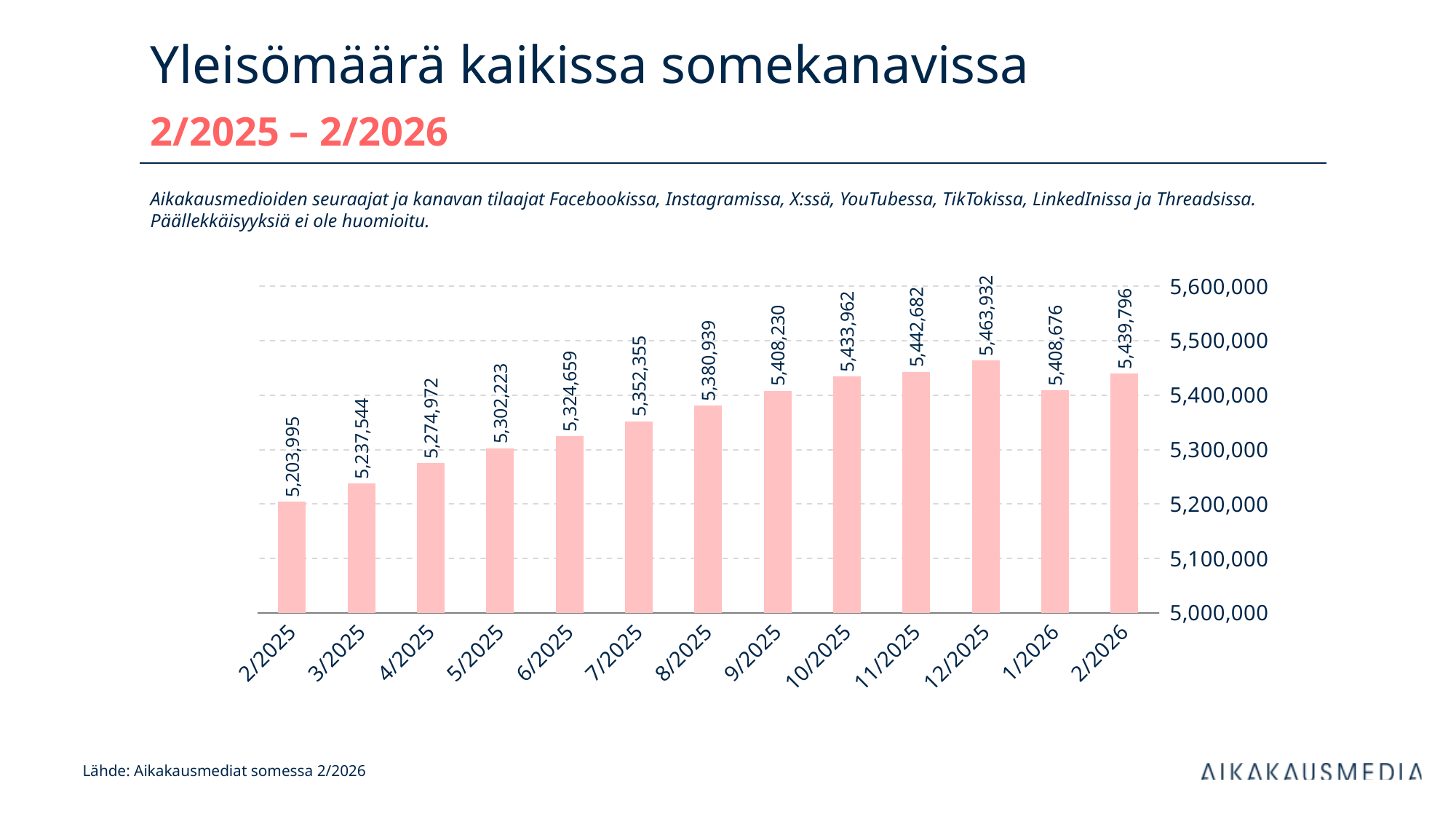
What is the value for 2/2025? 5,203,995 What is the value for 2/2026? 5,439,796 What is the value for 12/2025? 5,463,932 Is the value for 7/2025 greater or less than 5,400,000? less Which month has the lowest value? 2/2025 How many months are shown on the x axis? 13 What is the difference between the values for 2/2026 and 2/2025? 235,801 What kind of chart is shown on the slide? bar chart Which is larger, the value for 12/2025 or the value for 1/2026? 12/2025 Which month has the highest value? 12/2025 What is the value for 1/2026? 5,408,676 What is the difference between the values for 12/2025 and 1/2026? 55,256